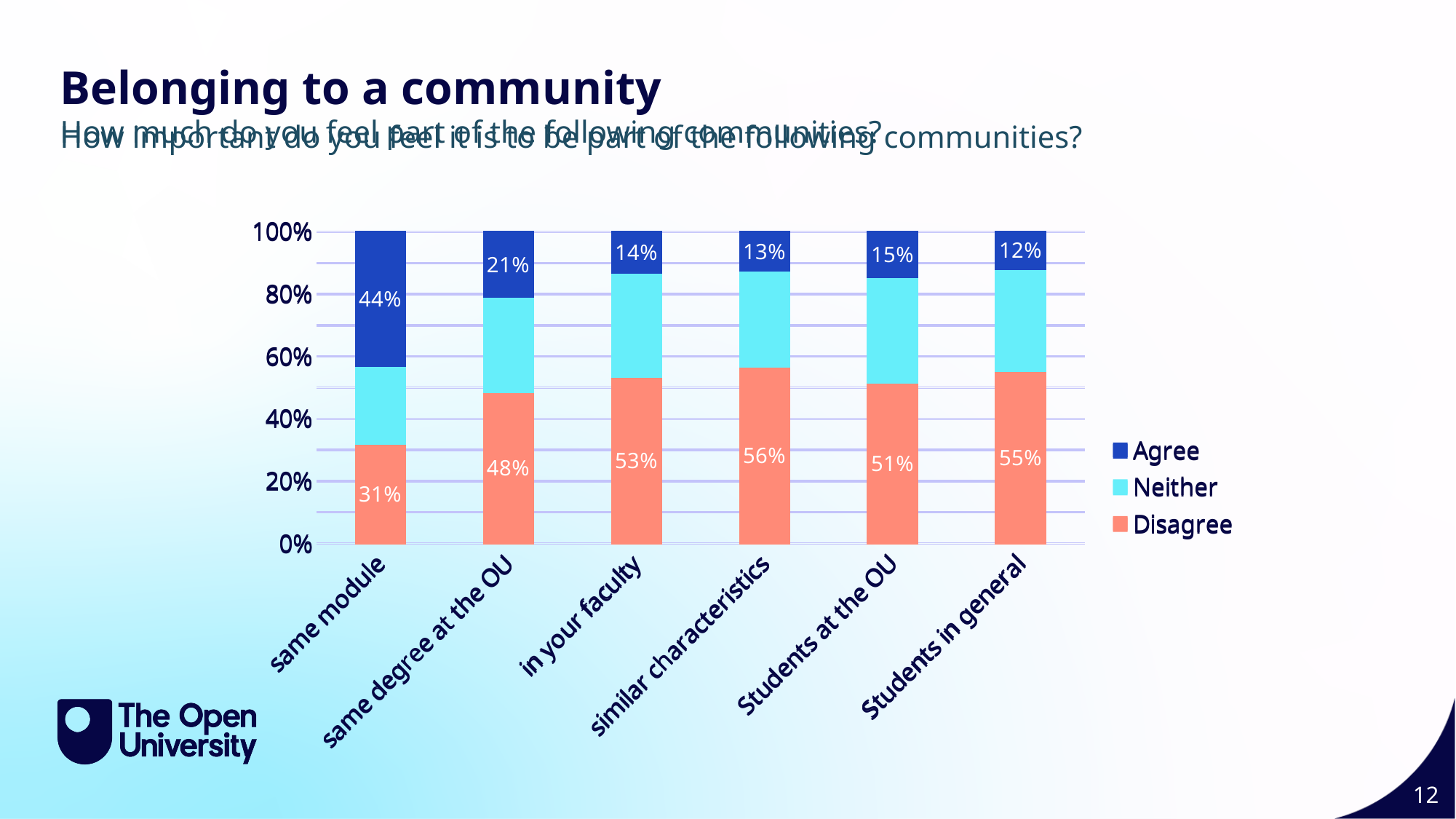
Which is larger: the Disagree value for 'in your faculty' or for 'Students at the OU'? in your faculty What is the Agree value for 'Students at the OU'? 15% How many communities are shown on the x axis? 6 What is the difference in Agree percentage between 'same module' and 'same degree at the OU'? 23 percentage points Which community has the highest Disagree percentage? similar characteristics What percentage of respondents agree for the 'same module' community? 44% What kind of chart is shown on the slide? stacked bar chart Which community has the highest Agree percentage? same module What is the Disagree value for 'Students in general'? 55% Is the Neither value for 'same module' greater or less than 20%? greater How many series does the legend list? 3 Which community has the lowest Agree percentage? Students in general